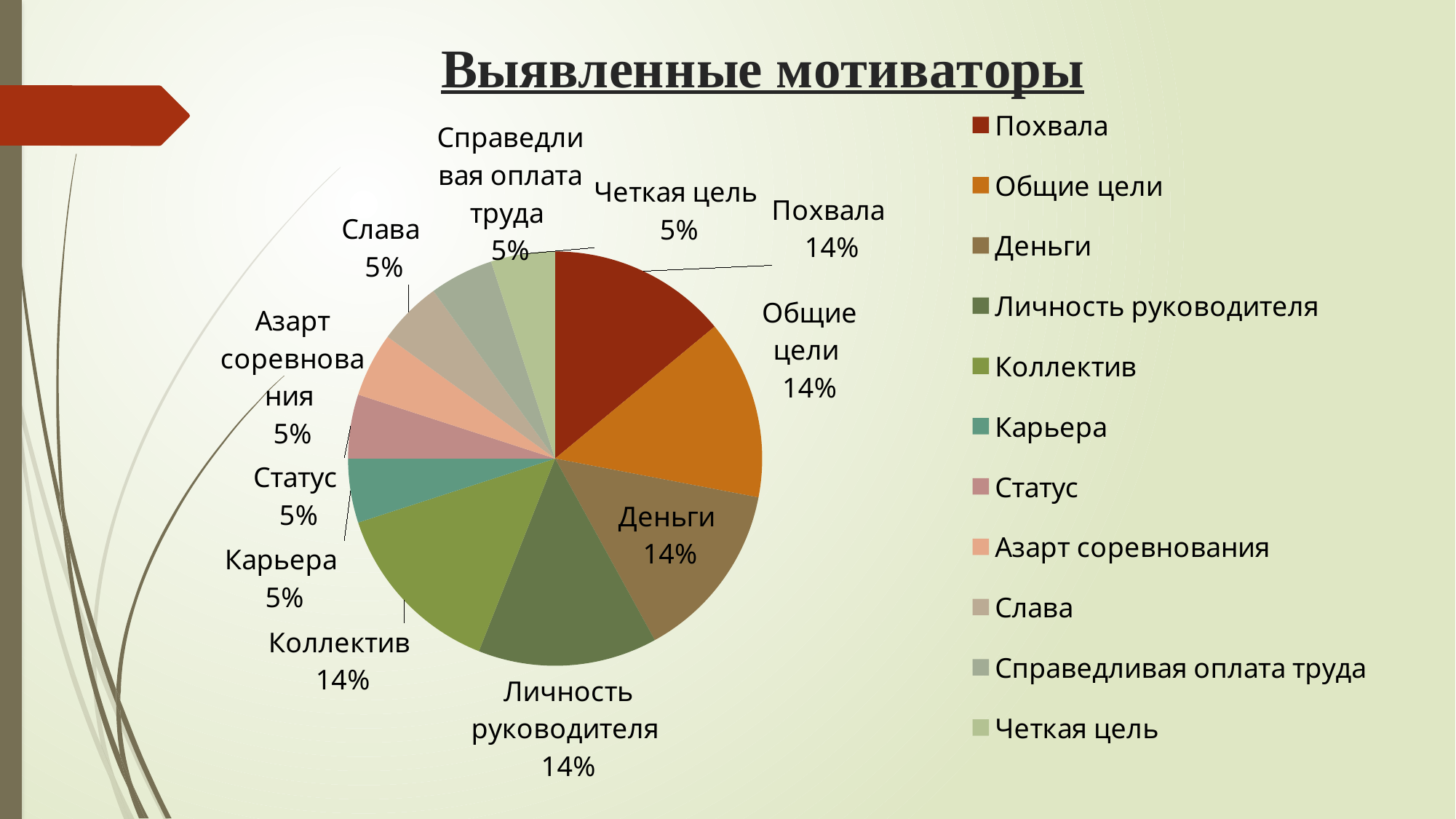
What is the value shown for Личность руководителя? 14% Which is larger, Коллектив or Статус? Коллектив What share of the pie does Похвала have? 14% What is the difference between the shares of Общие цели and Четкая цель? 9% What is the difference between the shares of Деньги and Азарт соревнования? 9% How many entries does the legend list? 11 What is the value shown for Справедливая оплата труда? 5% What type of chart is shown on the slide? Pie chart How many slices does the pie chart have? 11 Which is larger, Слава or Деньги? Деньги What share of the pie does Карьера have? 5% What is the title of the chart? Выявленные мотиваторы